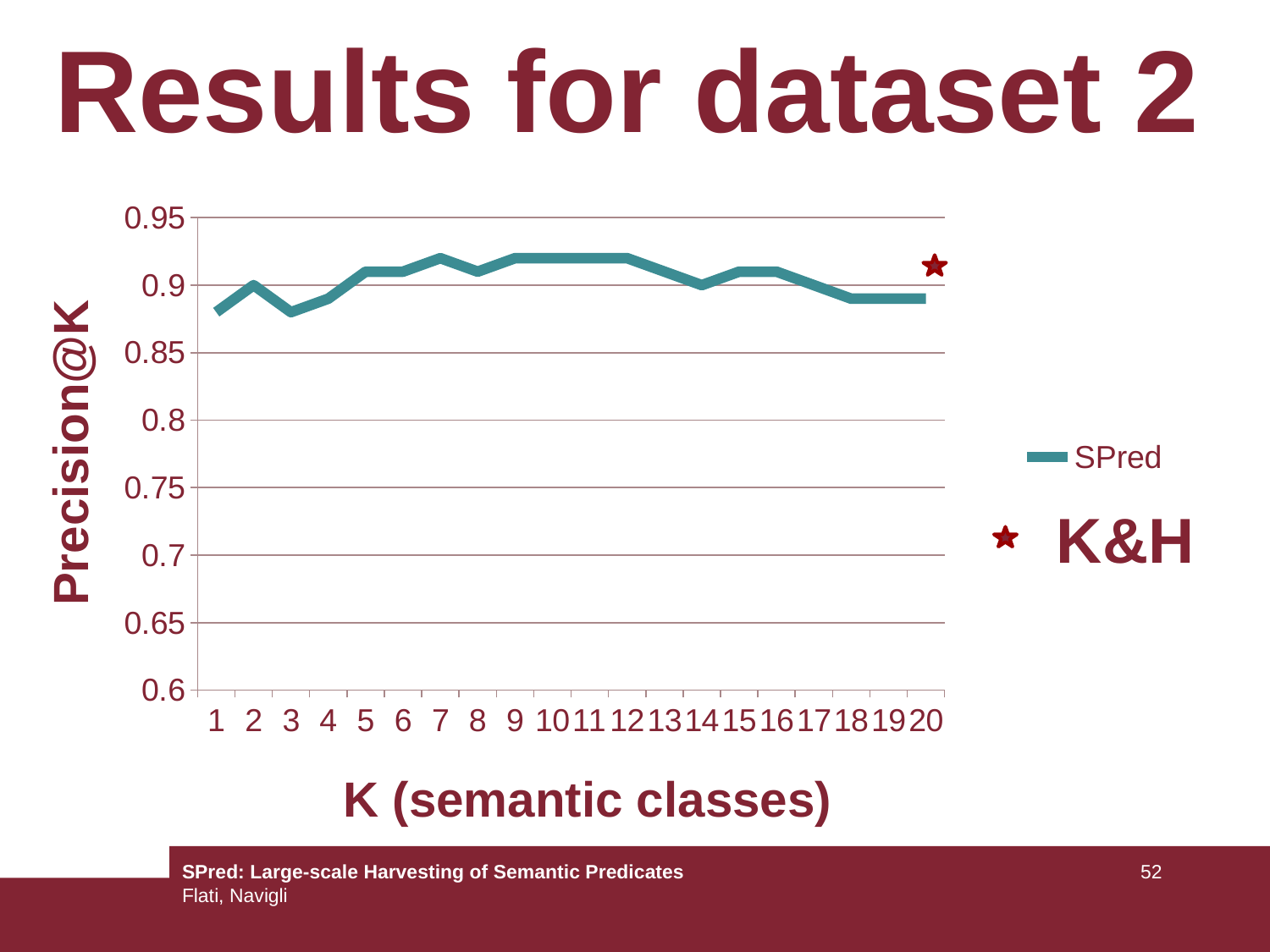
How many entries does the legend list? 2 What kind of chart is shown on the slide? line chart Which has the higher SPred value, K=1 or K=7? K=7 Between K=12 and K=14, does the SPred line rise or fall? fall Is the SPred value at K=10 greater or less than 0.9? greater What is the label of the x axis? K (semantic classes) Is the SPred value at K=1 greater or less than 0.9? less Which has the higher SPred value, K=3 or K=10? K=10 Is the SPred value at K=3 greater or less than 0.85? greater What is the label of the y axis? Precision@K How many K values are plotted along the x axis? 20